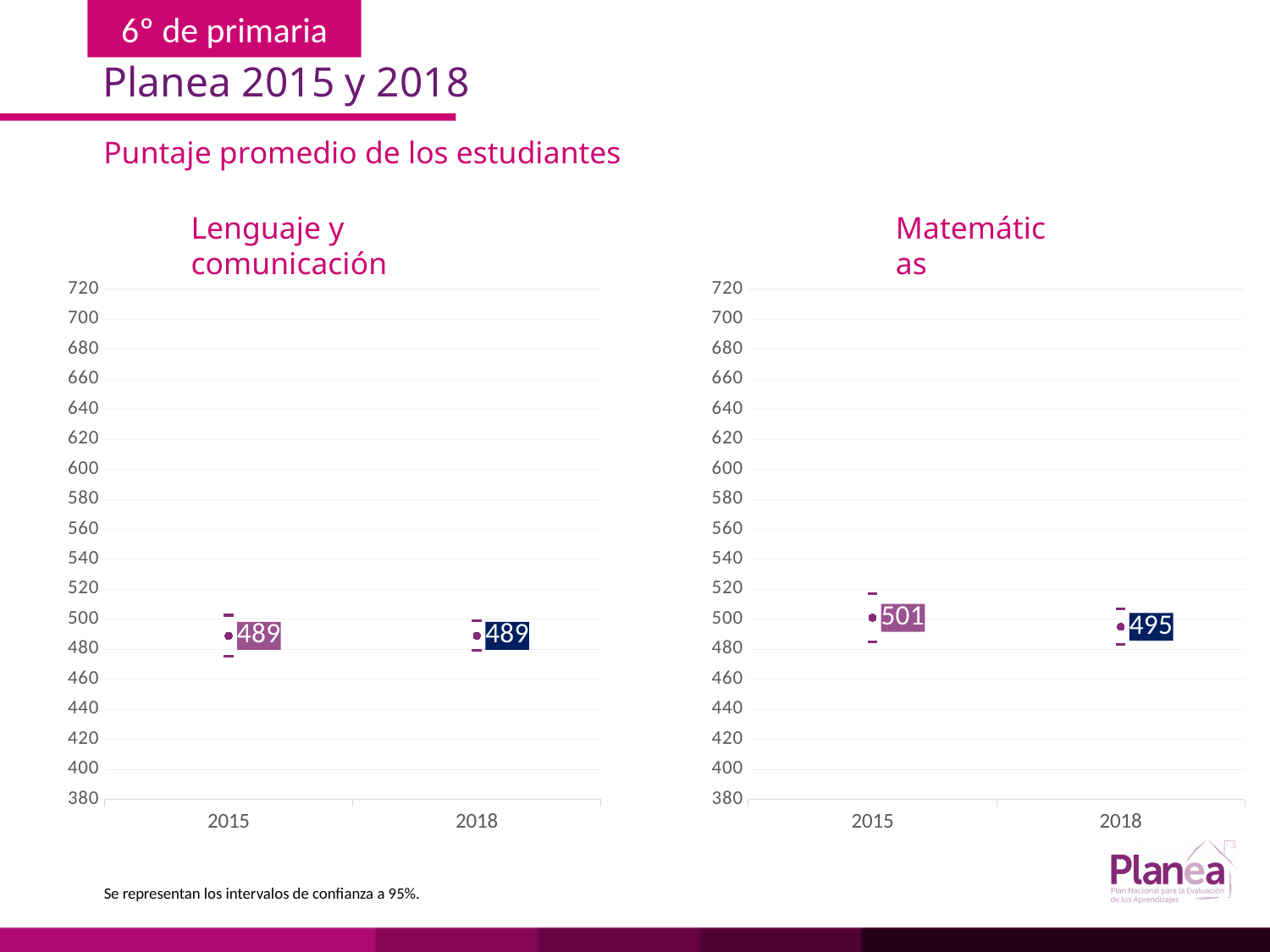
How many years (categories) are shown on the x axis of the Lenguaje y comunicación chart? 2 In the Matemáticas chart, what is the average score for 2018? 495 In the Lenguaje y comunicación chart, what is the average score for 2018? 489 In the Matemáticas chart, what is the difference between the 2015 and 2018 average scores? 6 In the Lenguaje y comunicación chart, what is the difference between the 2015 and 2018 average scores? 0 In the Matemáticas chart, do the average scores rise or fall from 2015 to 2018? fall In the Matemáticas chart, what is the average score for 2015? 501 In the Matemáticas chart, is the 2015 value greater or less than 500? greater According to the note at the bottom of the slide, what confidence level do the intervals represent? 95% In the Matemáticas chart, which year has the higher average score? 2015 What is the lowest value shown on the y axis of the Matemáticas chart? 380 In the Lenguaje y comunicación chart, what is the average score for 2015? 489